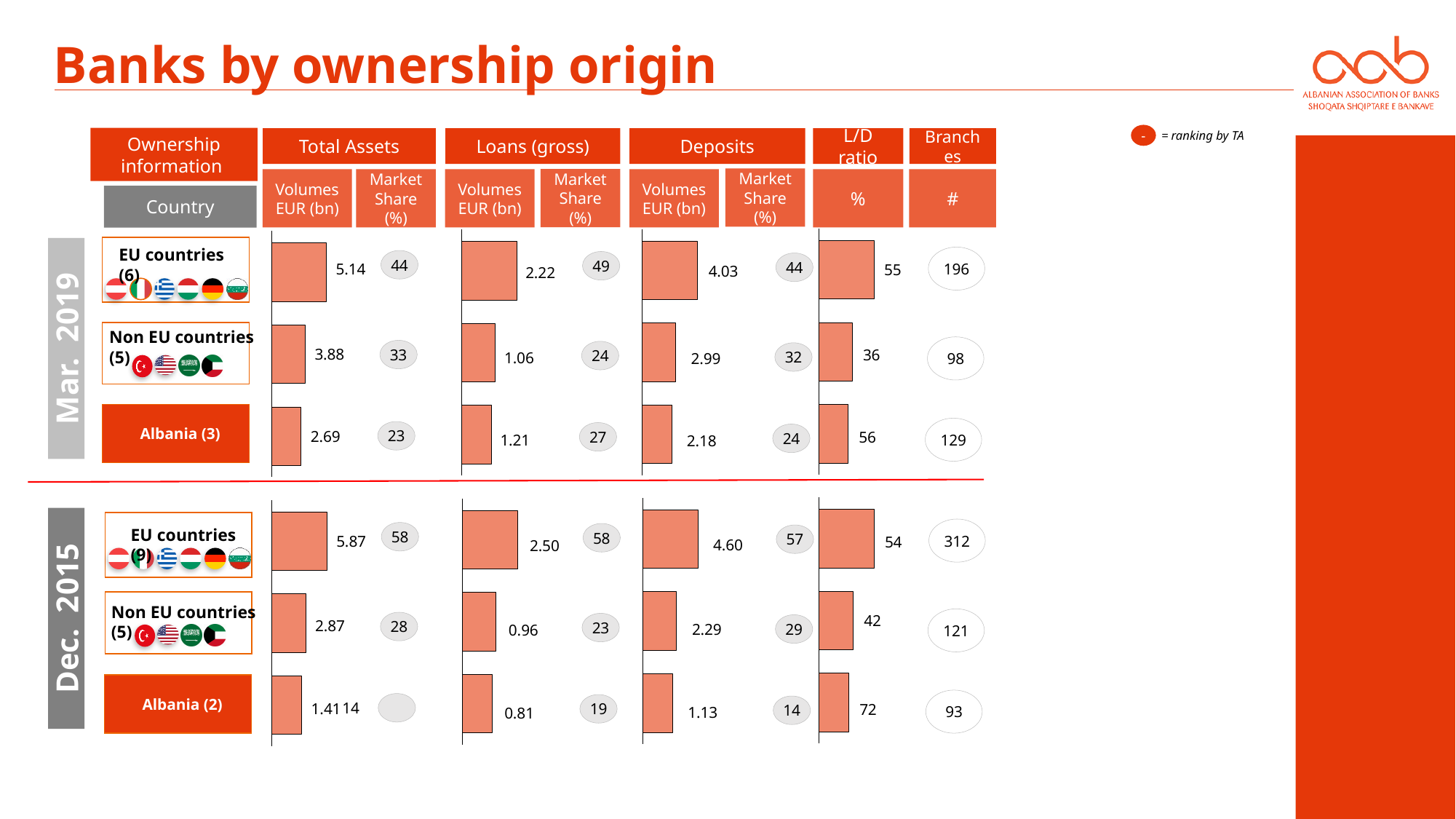
In the Mar. 2019 Total Assets chart, what is the difference in volume (EUR bn) between EU countries and Non EU countries? 1.26 What kind of chart is used to show the Total Assets volumes on the slide? Bar chart In the Dec. 2015 Loans (gross) chart, what is the volume (EUR bn) for Non EU countries? 0.96 In the Dec. 2015 Deposits chart, which ownership group has the lowest volume? Albania In the Dec. 2015 L/D ratio chart, what is the value for Albania? 72 In the Mar. 2019 Total Assets chart, which ownership group has the highest volume? EU countries In the Mar. 2019 Deposits chart, what is the volume (EUR bn) for Albania? 2.18 In the Mar. 2019 Total Assets chart, what is the volume (EUR bn) for EU countries? 5.14 In the Dec. 2015 Total Assets chart, what is the difference in volume (EUR bn) between EU countries and Non EU countries? 3.00 How many ownership groups (bars) are shown in the Mar. 2019 Deposits chart? 3 In the Dec. 2015 L/D ratio chart, which is larger: the value for EU countries or for Non EU countries? EU countries In the Mar. 2019 Loans (gross) chart, which is larger: the volume for Non EU countries or for Albania? Albania